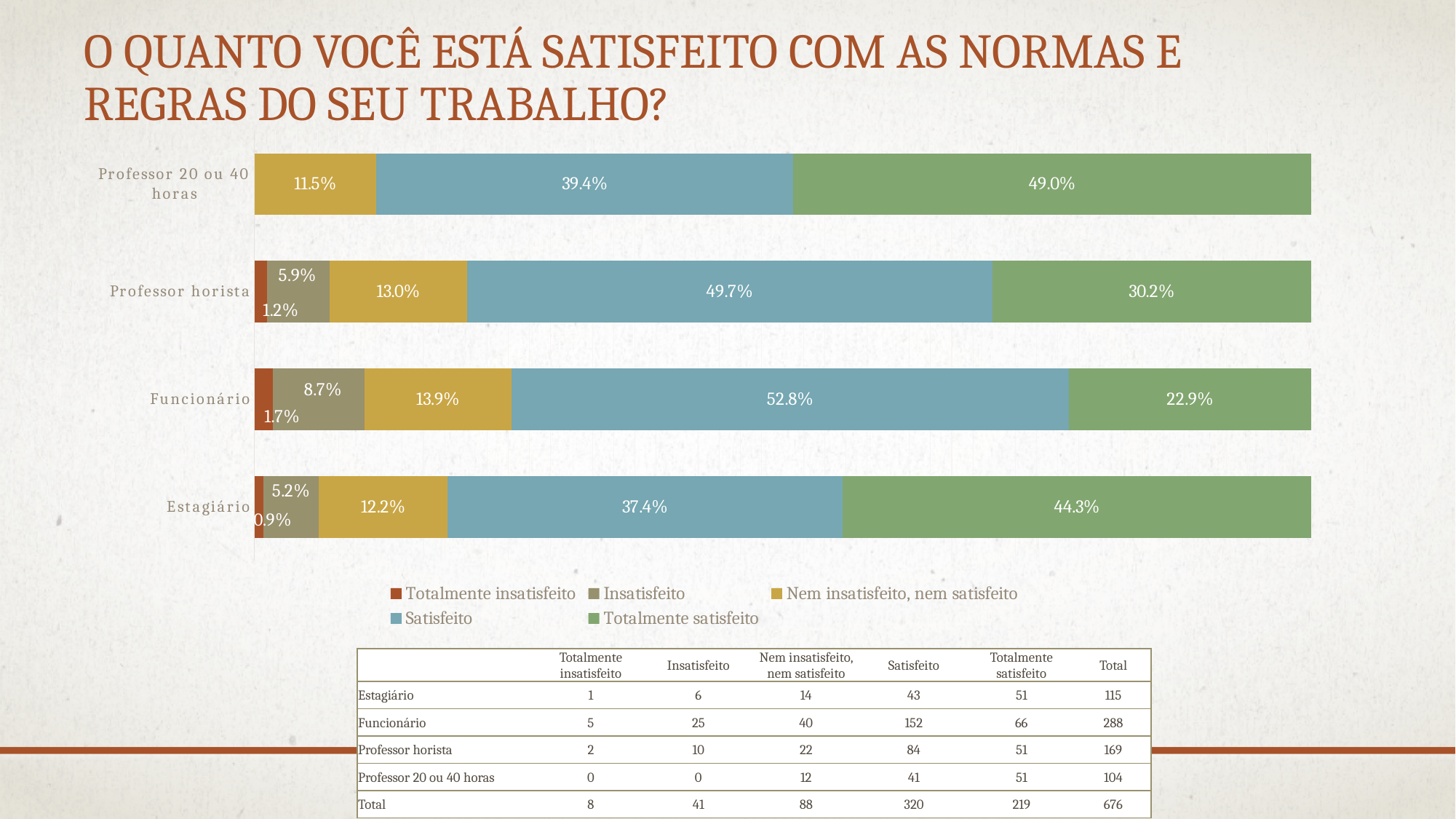
What is the difference in percentage points between the 'Totalmente satisfeito' values for 'Estagiário' and 'Funcionário'? 21.4 percentage points What is the 'Insatisfeito' value for 'Professor horista'? 5.9% How many categories (bars) are shown in the chart? 4 What kind of chart is shown on the slide? Stacked bar chart Which category has the lowest 'Satisfeito' percentage? Estagiário What is the 'Totalmente insatisfeito' value for 'Estagiário'? 0.9% What is the difference in percentage points between the 'Satisfeito' values for 'Professor horista' and 'Professor 20 ou 40 horas'? 10.3 percentage points What is the 'Satisfeito' value for 'Funcionário'? 52.8% What percentage of 'Professor 20 ou 40 horas' respondents are 'Totalmente satisfeito'? 49.0% Which has a larger 'Nem insatisfeito, nem satisfeito' share: 'Funcionário' or 'Professor horista'? Funcionário How many series does the legend list? 5 Which category has the highest 'Totalmente satisfeito' percentage? Professor 20 ou 40 horas